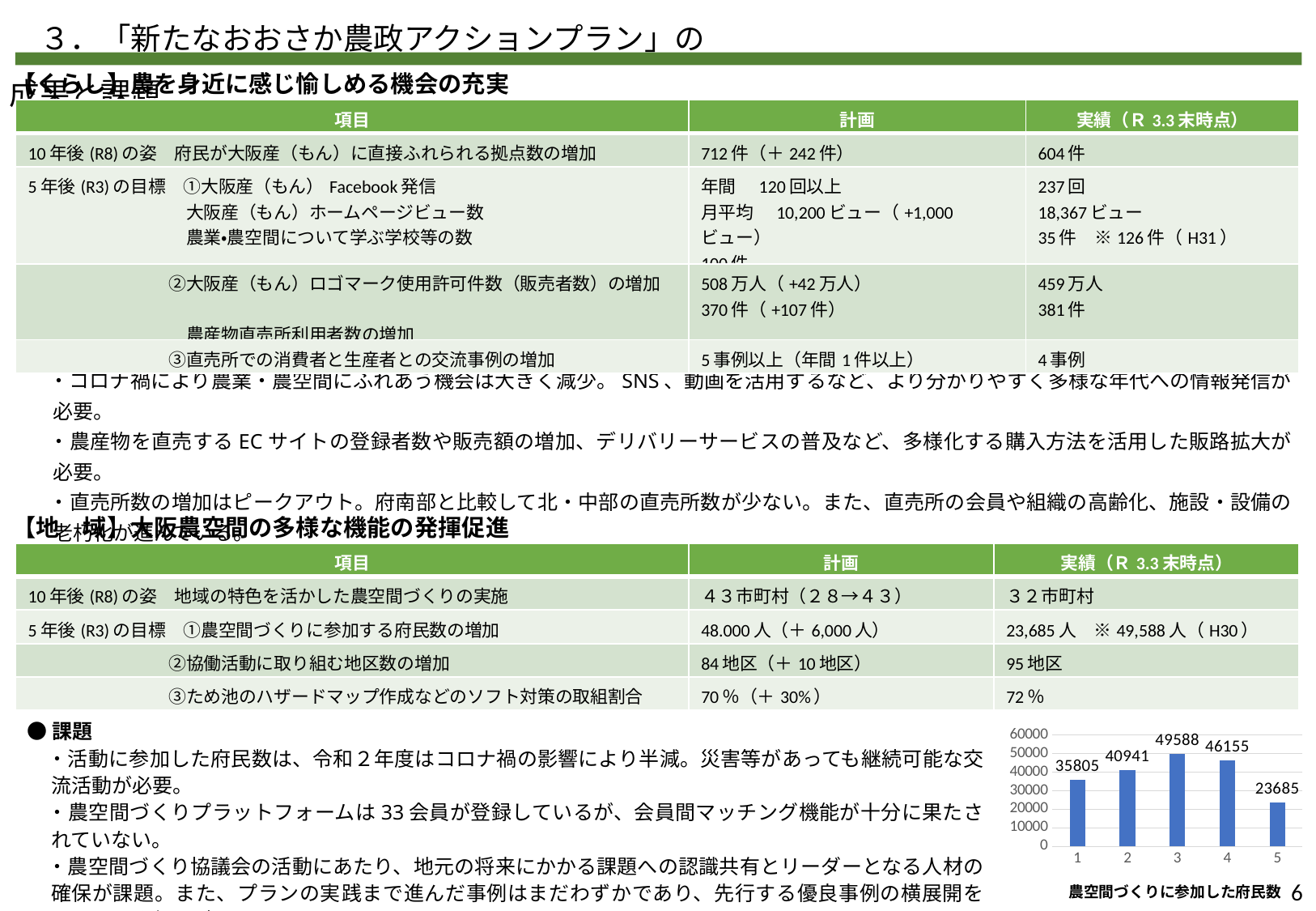
How many bars are plotted in the bar chart? 5 In the bar chart, what is the value for category 3? 49588 In the bar chart, what is the difference between the values for category 2 and category 1? 5136 In the bar chart, which is larger: the value for category 2 or the value for category 4? category 4 What is the title of the bar chart at the bottom right of the slide? 農空間づくりに参加した府民数 In the bar chart, what is the difference between the values for category 3 and category 4? 3433 In the bar chart, what is the value for category 5? 23685 In the bar chart, what is the value for category 1? 35805 In the bar chart, is the value for category 5 greater or less than 30000? less What type of chart is shown at the bottom right of the slide? bar chart Which category has the lowest value in the bar chart? 5 Which category has the highest value in the bar chart? 3